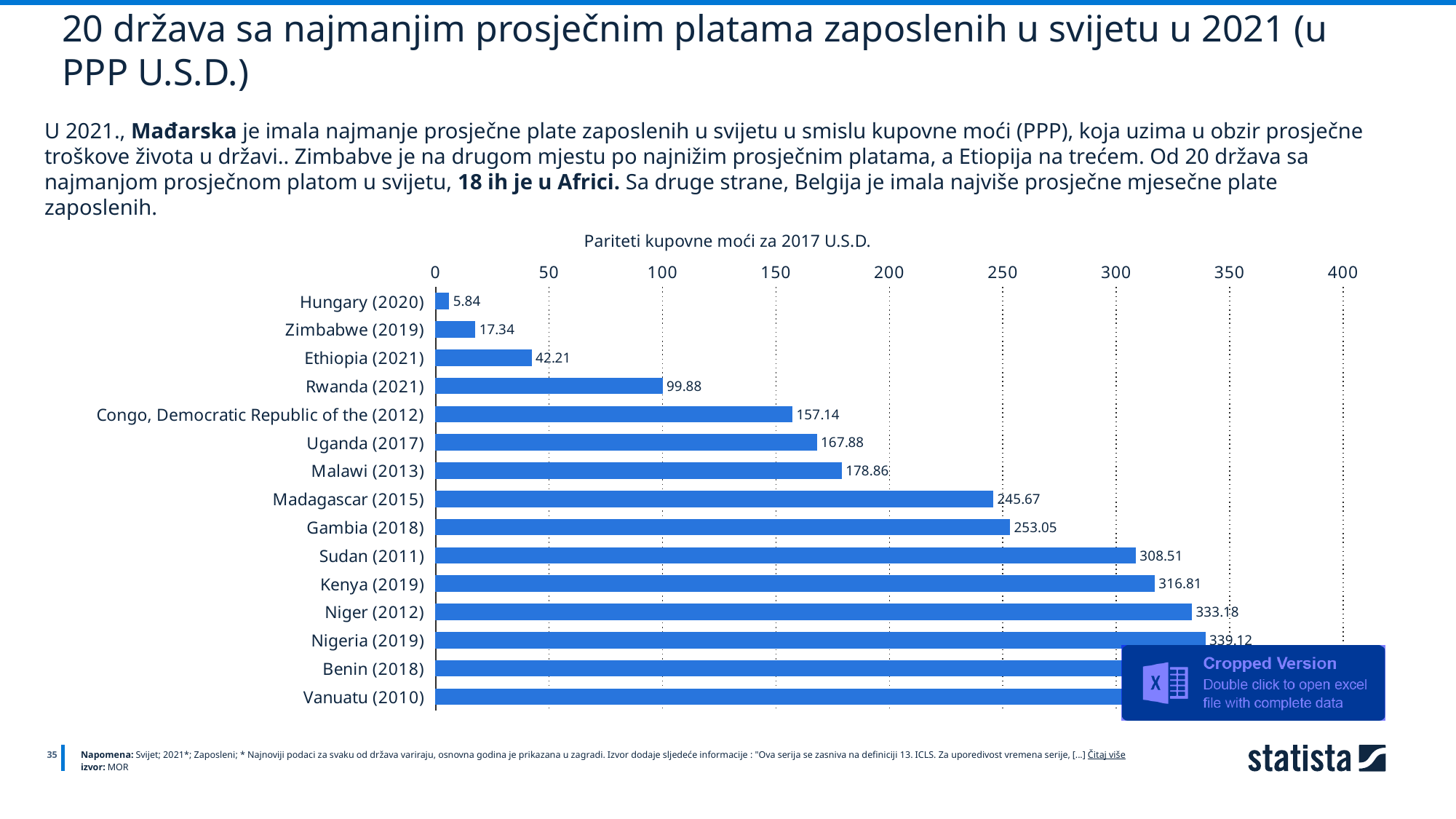
What is the difference between the values for Gambia (2018) and Madagascar (2015)? 7.38 What is the value for Nigeria (2019)? 339.12 What is the difference between the values for Zimbabwe (2019) and Hungary (2020)? 11.50 Is the value for Benin (2018) greater or less than 250? greater What type of chart is shown on the slide? bar chart Which has a larger value, Sudan (2011) or Malawi (2013)? Sudan (2011) What is the value for Rwanda (2021)? 99.88 What is the value for Madagascar (2015)? 245.67 Which country has the lowest value in the chart? Hungary (2020) How many countries are shown in the chart? 15 What is the axis title shown above the chart? Pariteti kupovne moći za 2017 U.S.D. What is the value for Hungary (2020)? 5.84